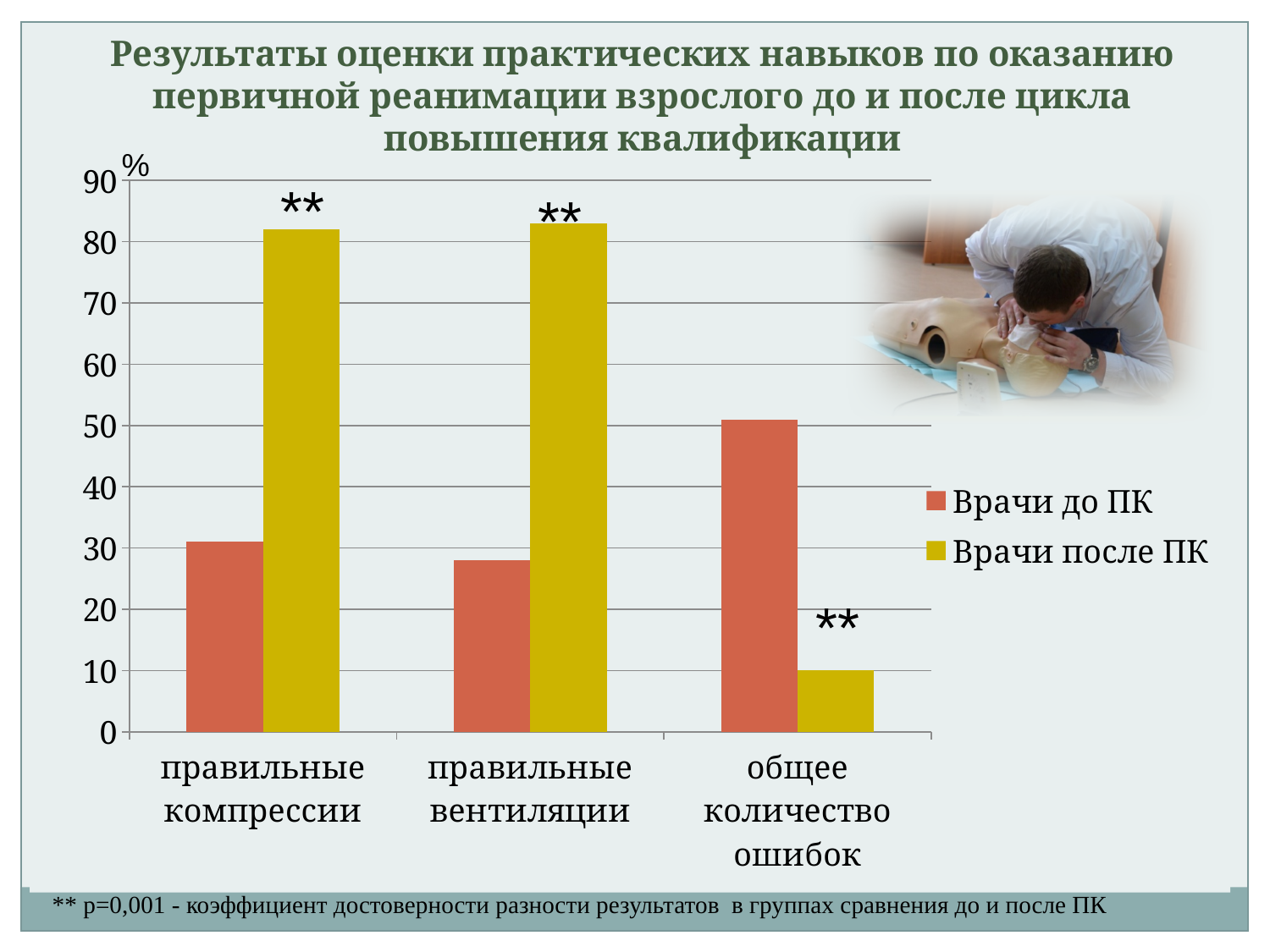
Is the value for Врачи после ПК in правильные компрессии greater or less than 80? greater Is the value for Врачи после ПК in общее количество ошибок greater or less than 20? less How many series does the legend list? 2 For общее количество ошибок, which series has the larger value, Врачи до ПК or Врачи после ПК? Врачи до ПК What kind of chart is shown on the slide? bar chart How many categories are shown on the x axis? 3 In which category does the Врачи после ПК series have its lowest value? общее количество ошибок Which series does the yellow colour represent in the legend? Врачи после ПК Is the value for Врачи до ПК in правильные вентиляции greater or less than 20? greater In which category does the Врачи до ПК series have its highest value? общее количество ошибок